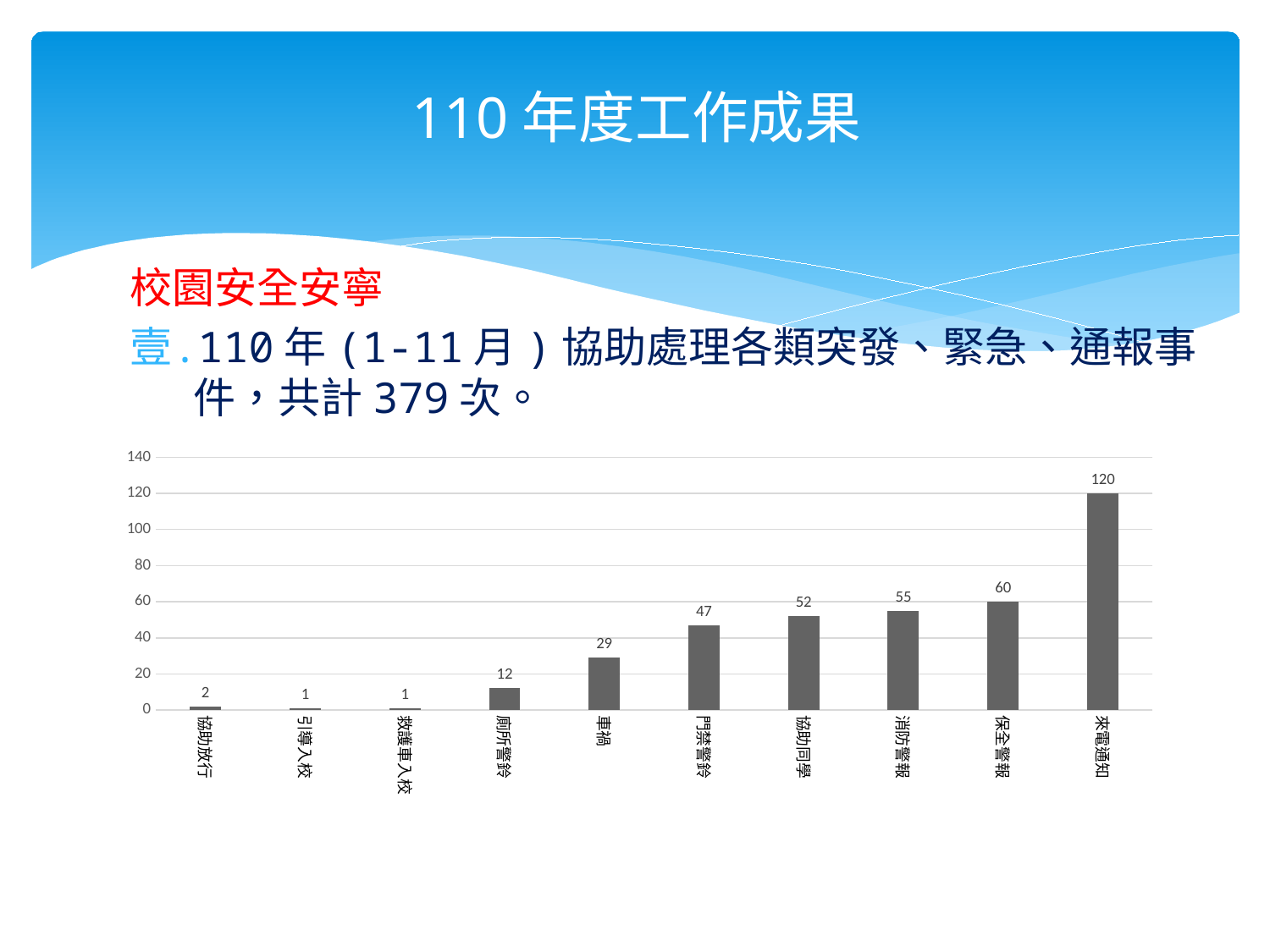
Do the values rise or fall from left to right along the x axis? rise What is the difference between the values for 來電通知 and 保全警報? 60 What is the difference between the values for 消防警報 and 門禁警鈴? 8 What kind of chart is shown on the slide? bar chart What is the value for 來電通知? 120 Which category has the highest value? 來電通知 Is the value for 來電通知 greater or less than 100? greater What is the value for 廁所警鈴? 12 Which is larger, the value for 保全警報 or the value for 協助同學? 保全警報 What is the value for 車禍? 29 How many categories are shown on the x axis? 10 What is the value for 協助同學? 52